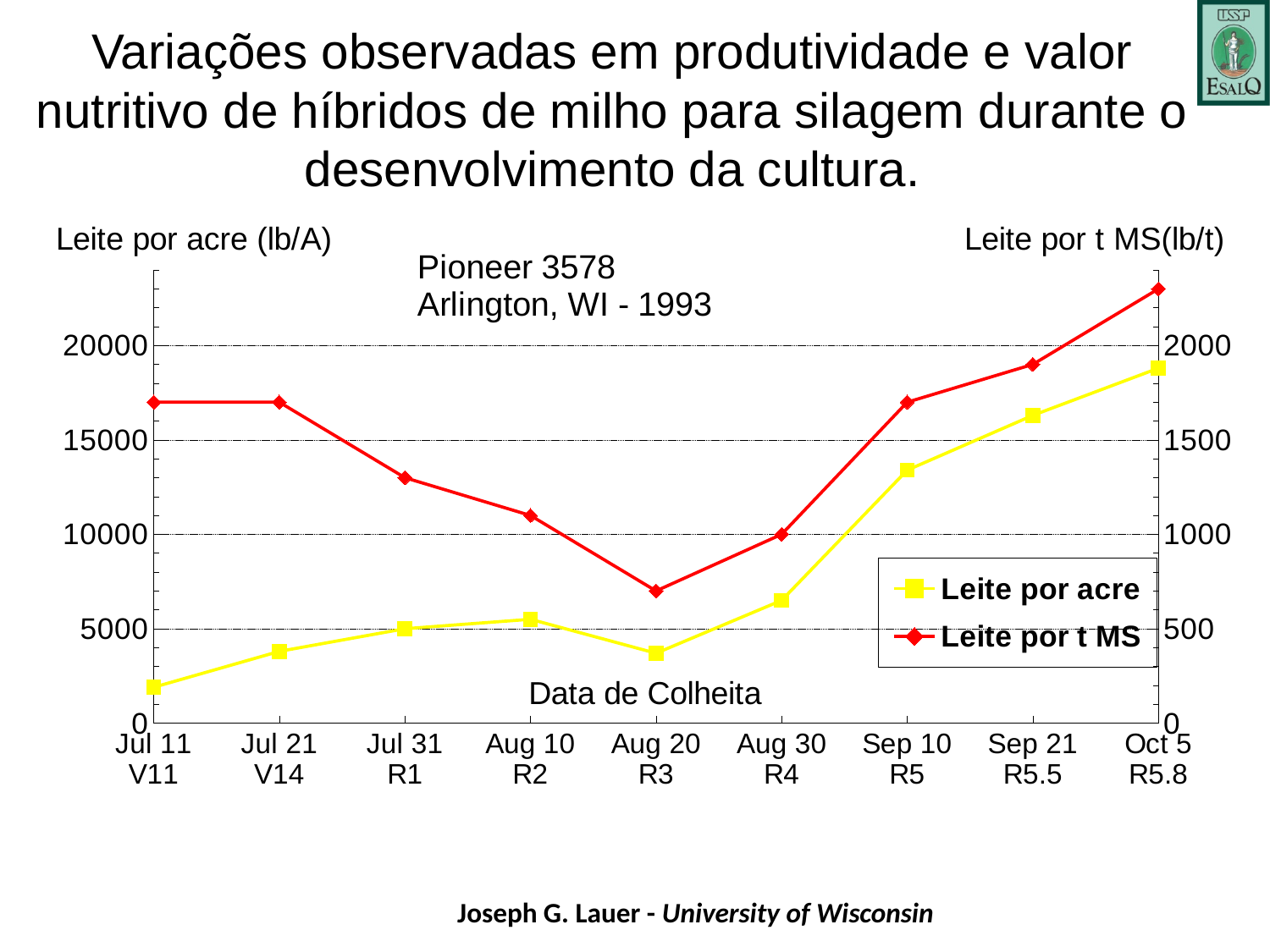
On which harvest date is Leite por t MS lowest? Aug 20 How many series does the legend list? 2 On which harvest date is Leite por acre lowest? Jul 11 What kind of chart is shown on the slide? line chart What is the value of Leite por acre on Jul 31? 5000 What is the value of Leite por t MS on Aug 30? 1000 Is the value for Leite por acre on Oct 5 greater or less than 15000? greater How many harvest dates are plotted along the x axis? 9 Is the value for Leite por t MS on Aug 20 greater or less than 1000? less What colour is the Leite por t MS line? red On which harvest date is Leite por acre highest? Oct 5 Does Leite por acre rise or fall from Aug 30 to Oct 5? rise